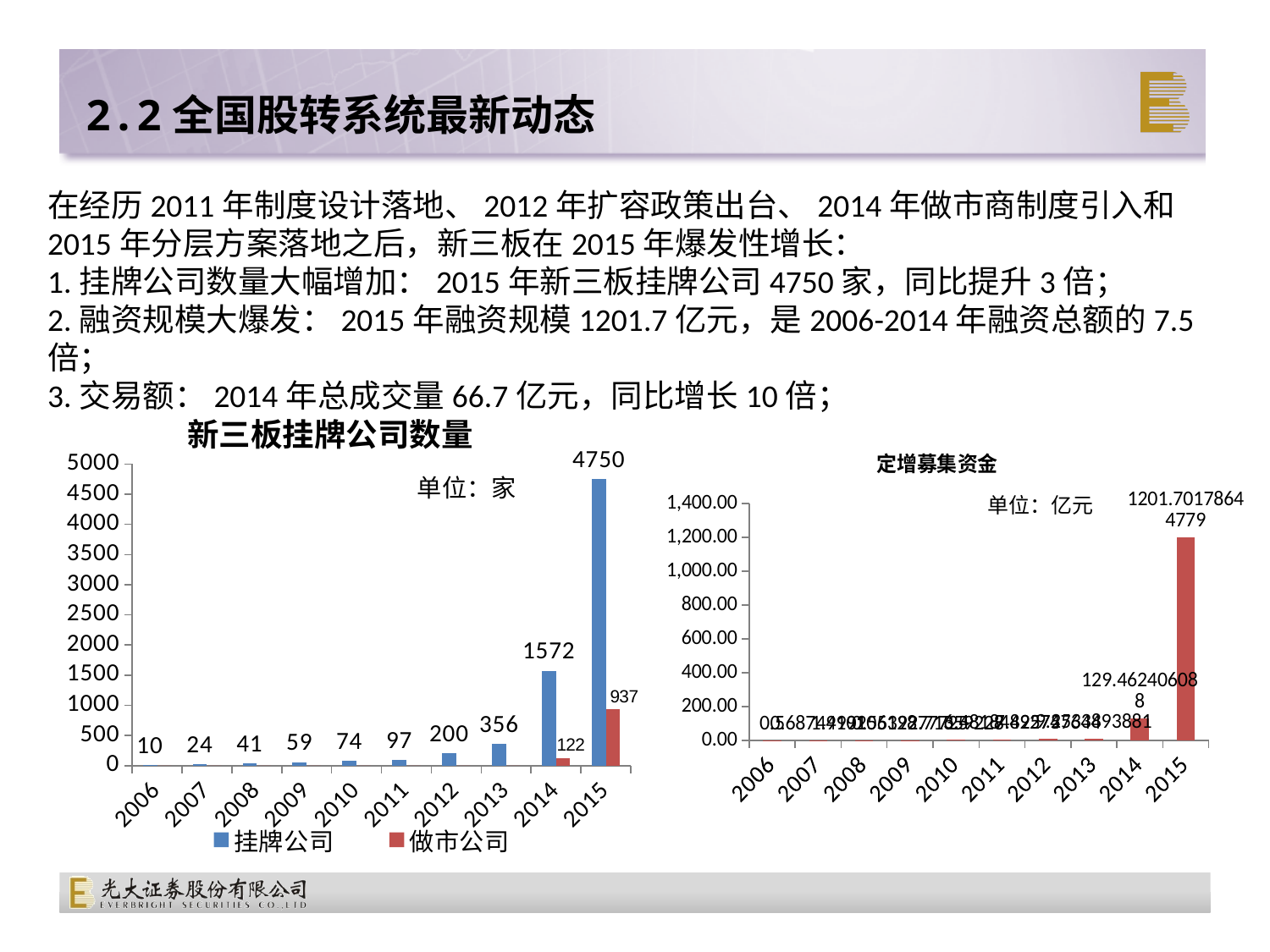
In the 新三板挂牌公司数量 chart, what is the value for 挂牌公司 in 2014? 1572 In the 新三板挂牌公司数量 chart, which year has the lowest 挂牌公司 value? 2006 In the 新三板挂牌公司数量 chart, what is the value for 挂牌公司 in 2015? 4750 In the 定增募集资金 chart, is the value for 2014 greater or less than 200.00? less In the 新三板挂牌公司数量 chart, do the 挂牌公司 values rise or fall from 2006 to 2015? rise In the 定增募集资金 chart, which year has the highest value? 2015 In the 新三板挂牌公司数量 chart, which is larger in 2014: 挂牌公司 or 做市公司? 挂牌公司 In the 新三板挂牌公司数量 chart, what is the difference between the 挂牌公司 values for 2015 and 2014? 3178 In the 新三板挂牌公司数量 chart, how many series does the legend list? 2 What kind of chart is the 定增募集资金 chart? bar chart In the 新三板挂牌公司数量 chart, what is the value for 挂牌公司 in 2010? 74 In the 新三板挂牌公司数量 chart, what is the value for 做市公司 in 2015? 937